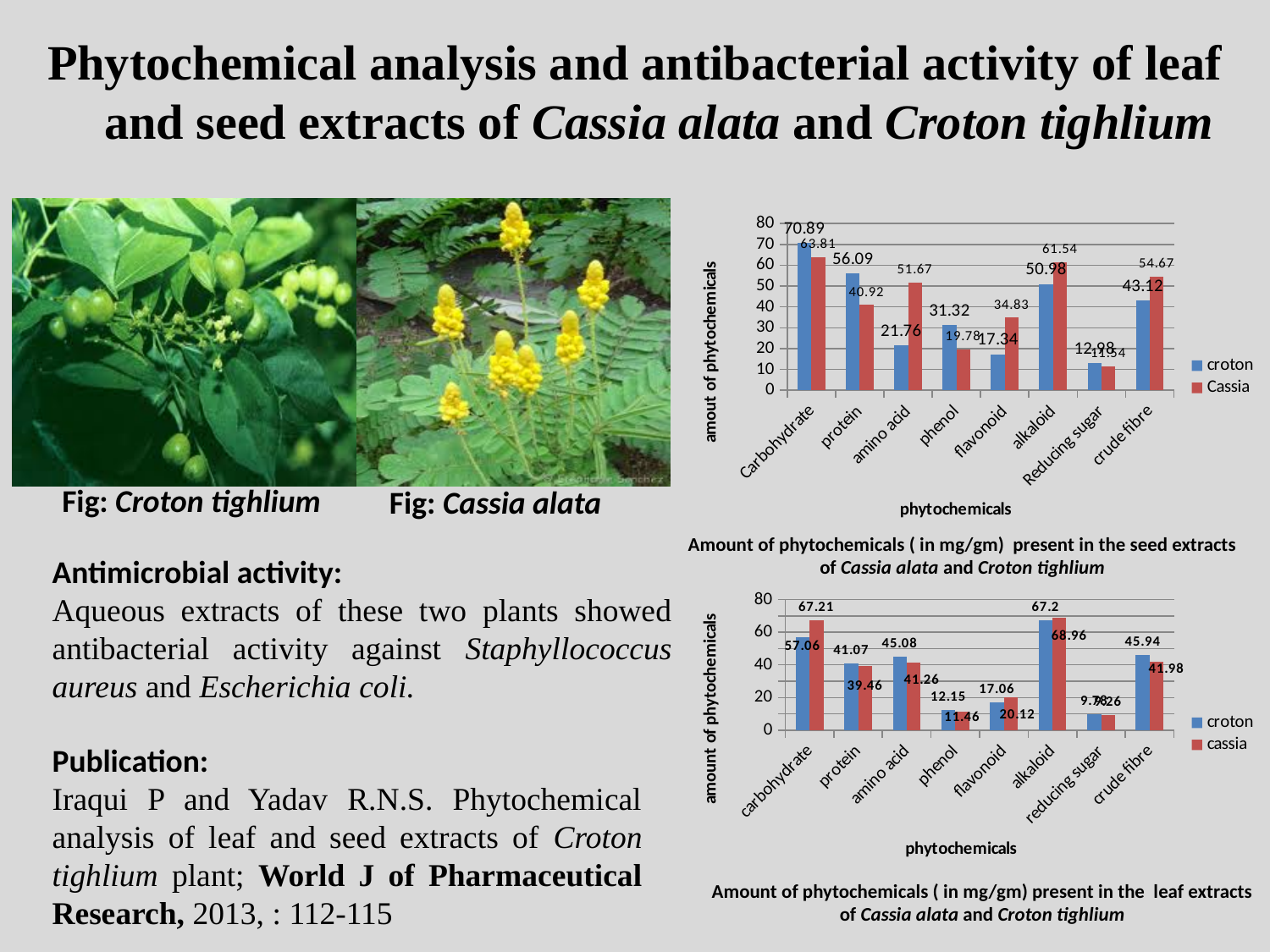
In the seed extracts chart, what is the difference between the croton and Cassia values for protein? 15.17 In the leaf extracts chart, is the croton value for phenol greater or less than 20? less In the seed extracts chart, which phytochemical has the highest value for croton? Carbohydrate In the seed extracts chart, which is larger for flavonoid, croton or Cassia? Cassia In the leaf extracts chart, what is the amount of crude fibre for croton? 45.94 In the seed extracts chart, what is the amount of amino acid for Cassia? 51.67 In the leaf extracts chart, which phytochemical has the highest value for cassia? alkaloid In the seed extracts chart, what is the amount of carbohydrate for croton? 70.89 In the leaf extracts chart, how many series does the legend list? 2 What type of chart is the leaf extracts chart? Bar chart In the seed extracts chart, how many phytochemical categories are shown on the x axis? 8 In the leaf extracts chart, what is the amount of carbohydrate for cassia? 67.21